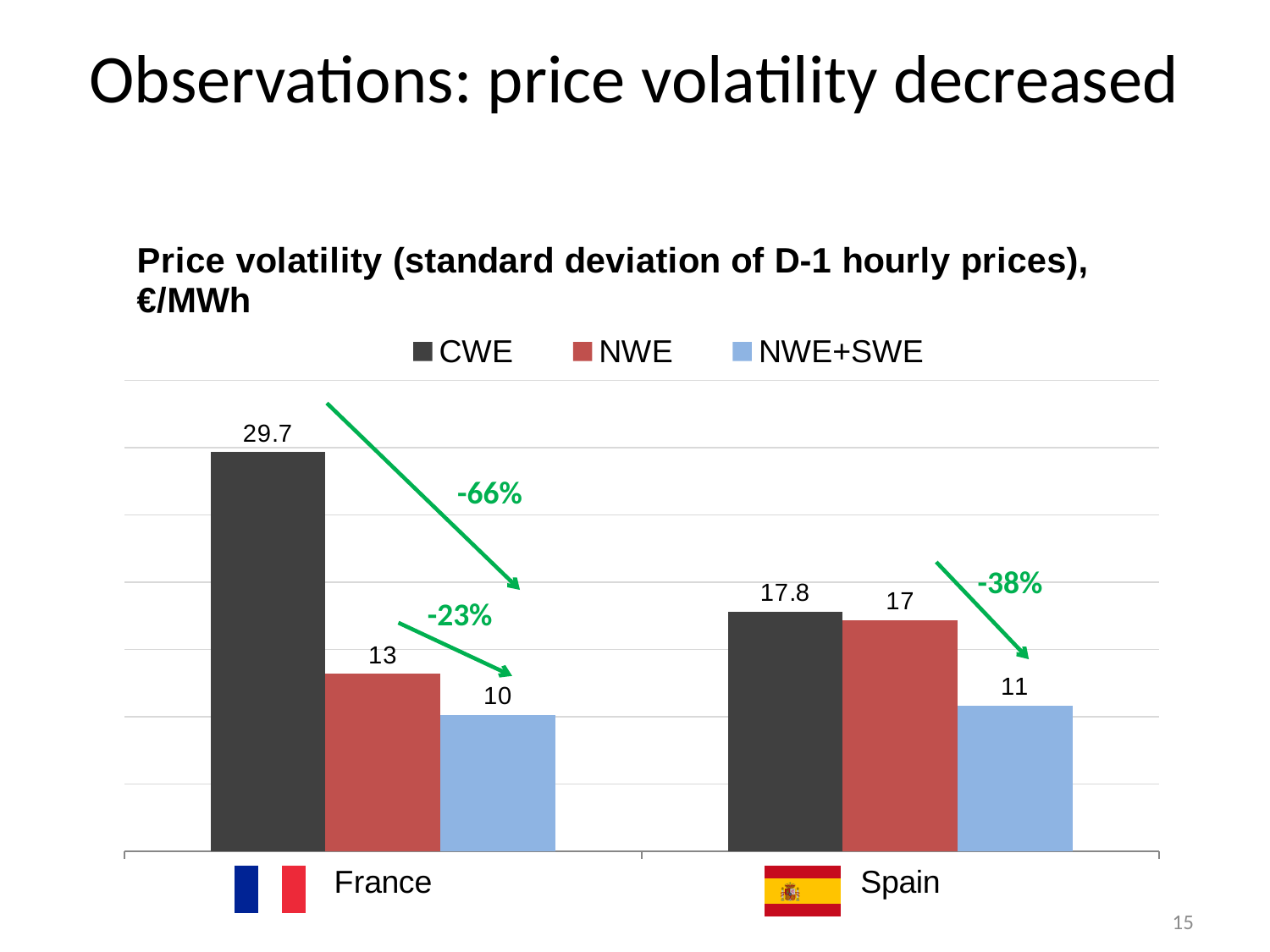
What is the CWE price volatility value for France? 29.7 Which series has the lowest value for France? NWE+SWE What is the difference between the NWE and NWE+SWE values for Spain? 6 Which is larger, the CWE value for France or the CWE value for Spain? France Which series has the highest value for Spain? CWE What is the difference between the CWE and NWE+SWE values for France? 19.7 What is the NWE value for France? 13 What kind of chart is shown on the slide? Bar chart What percentage change is annotated between the CWE and NWE+SWE bars for Spain? -38% What is the NWE+SWE price volatility value for Spain? 11 How many countries are shown on the x axis? 2 How many series does the legend list? 3